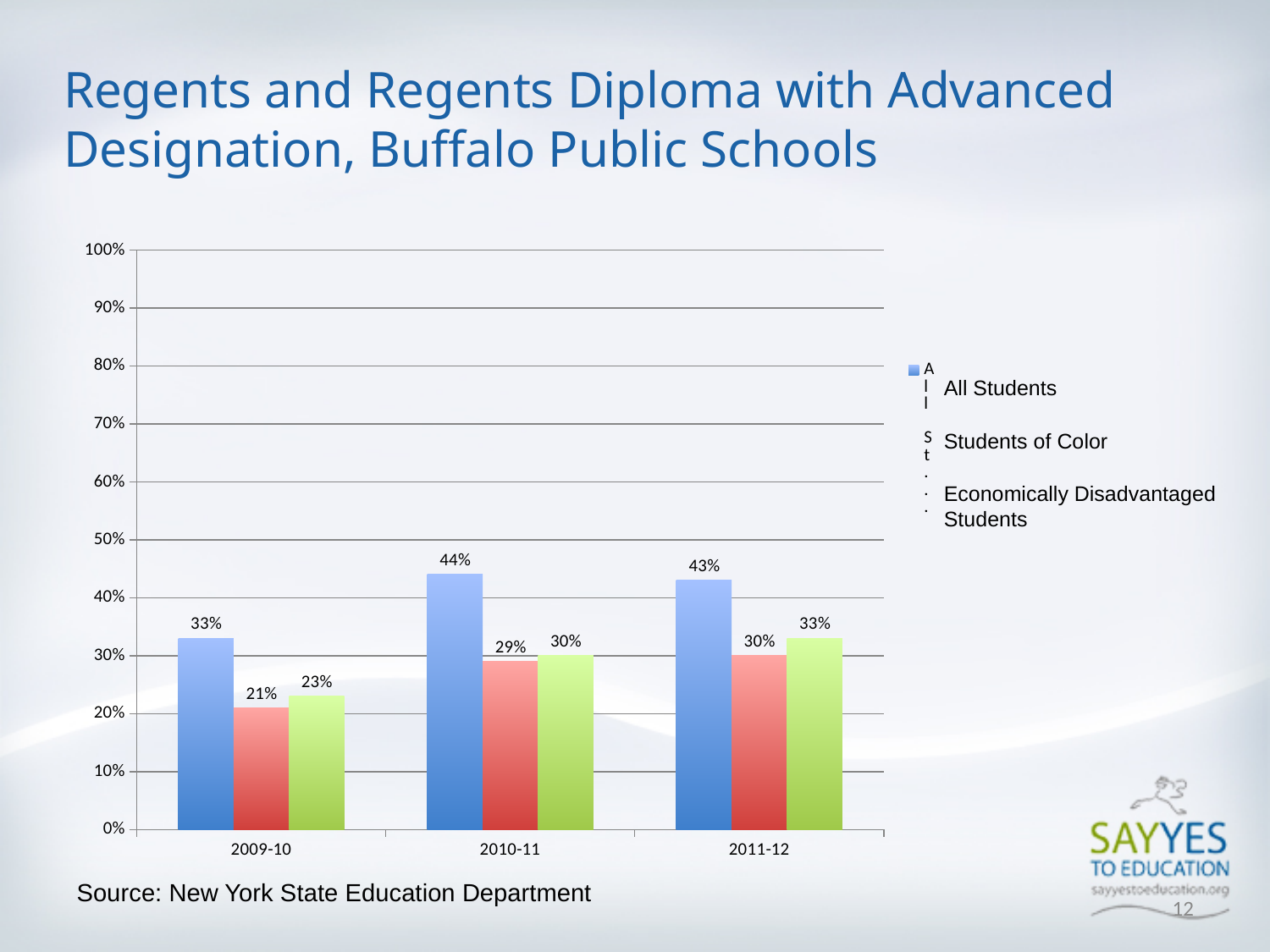
Which is larger in 2011-12: the value for All Students or the value for Economically Disadvantaged Students? All Students How many school years are shown on the x axis? 3 What kind of chart is shown on the slide? bar chart How many series does the legend list? 3 Is the value for All Students in 2011-12 greater or less than 40%? greater In which year is the value for All Students highest? 2010-11 What is the value for Students of Color in 2009-10? 21% In which year is the value for Students of Color lowest? 2009-10 What is the difference between the All Students value and the Students of Color value in 2009-10? 12% What is the value for Economically Disadvantaged Students in 2011-12? 33% What is the value for All Students in 2010-11? 44% Does the value for Economically Disadvantaged Students rise or fall from 2009-10 to 2011-12? rise